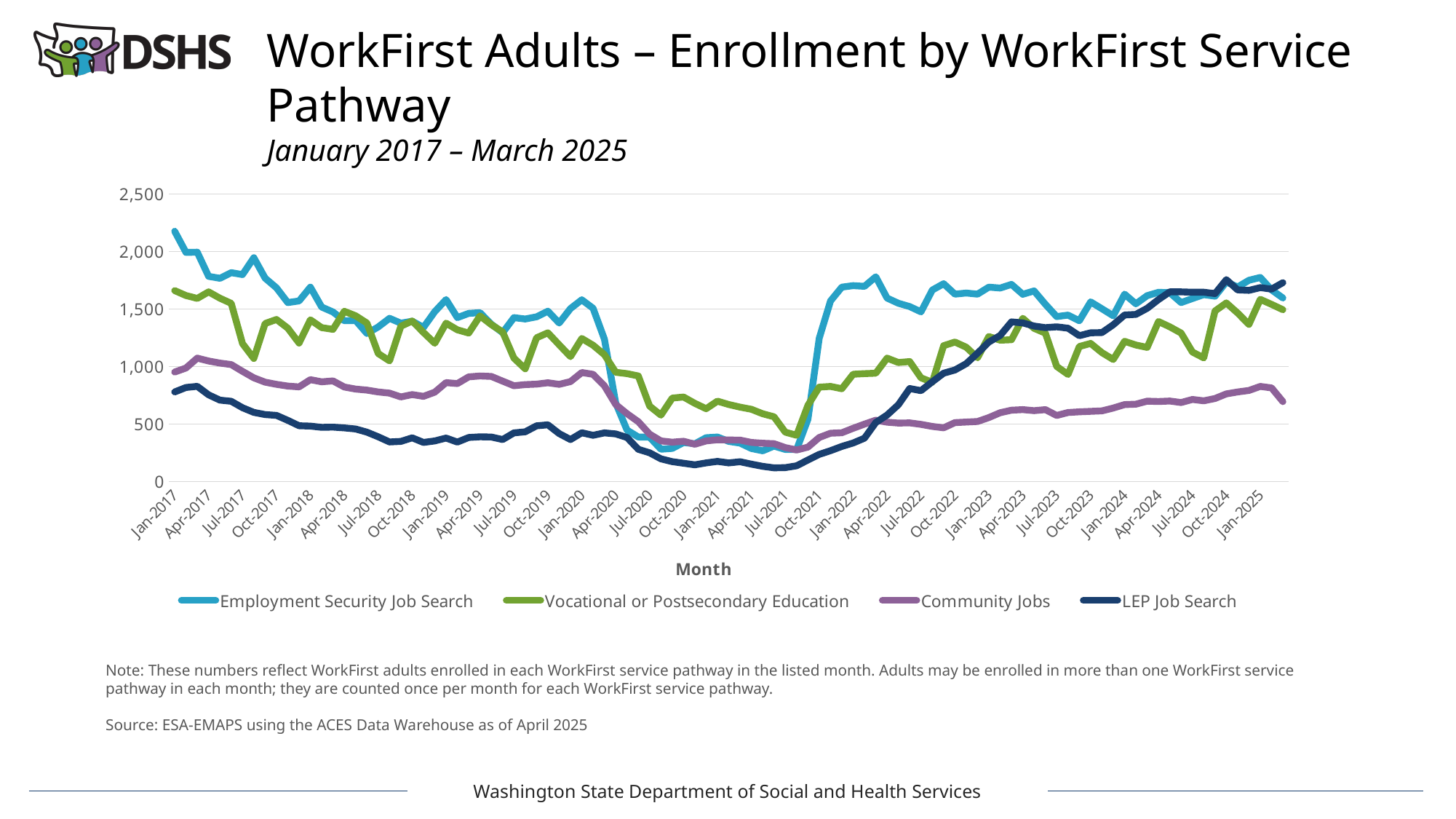
How many series does the legend list? 4 What kind of chart is shown on the slide? line chart Which series is lowest in Jan-2017? LEP Job Search Is the value for Employment Security Job Search in Jan-2017 greater or less than 2,000? greater Which series is highest in Jan-2017? Employment Security Job Search In Jan-2025, which is larger: LEP Job Search or Community Jobs? LEP Job Search What is the title of the x axis? Month Does the Employment Security Job Search line rise or fall between Jan-2017 and Jul-2020? fall Is the value for LEP Job Search in Jul-2021 greater or less than 500? less Is the value for Vocational or Postsecondary Education in Jan-2017 greater or less than 1,500? greater Does the LEP Job Search line rise or fall between Jul-2021 and Oct-2024? rise Which series is lowest in Jan-2025? Community Jobs